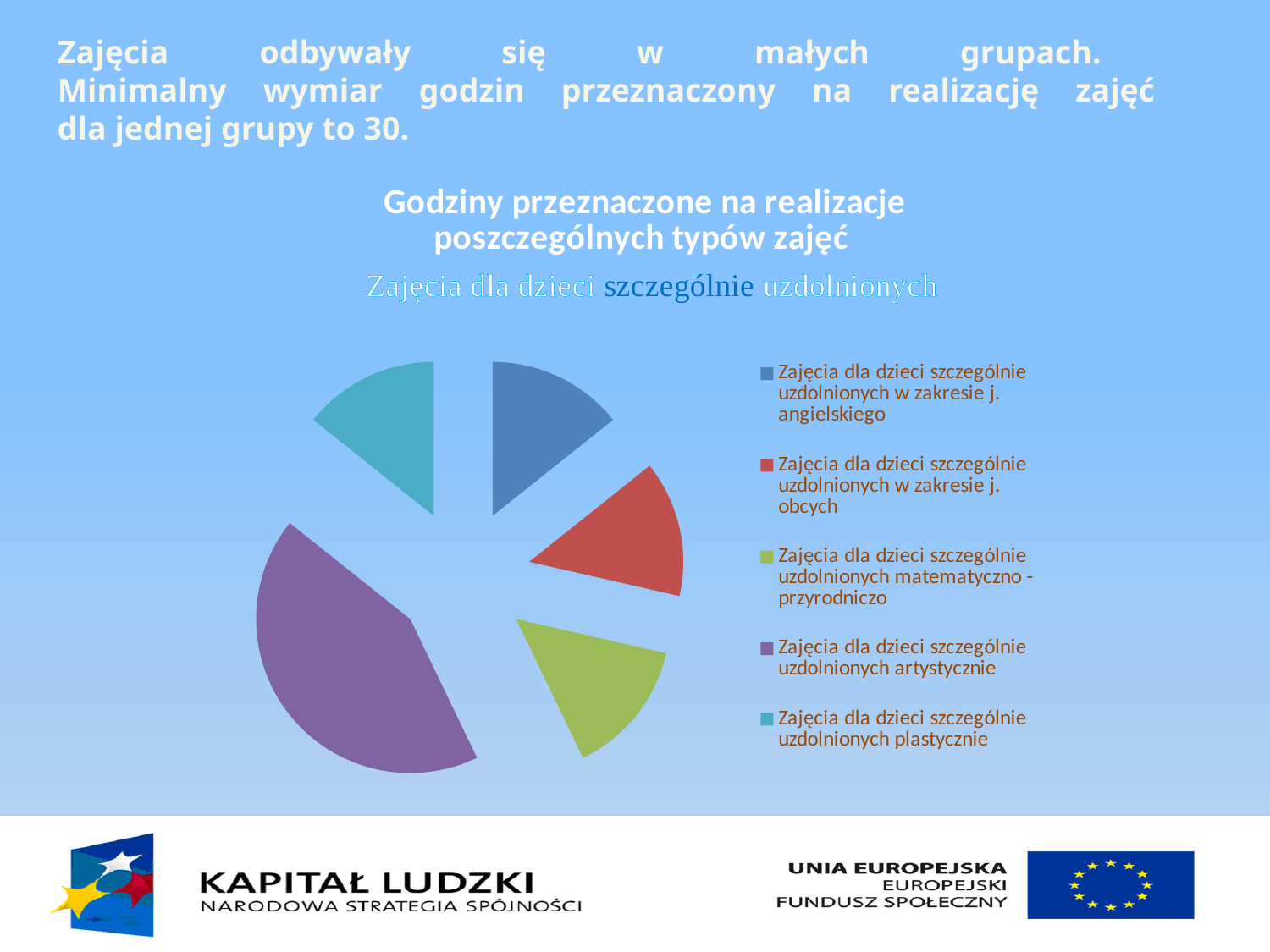
Which category has the largest slice in the pie chart? Zajęcia dla dzieci szczególnie uzdolnionych artystycznie What is the title of the pie chart? Godziny przeznaczone na realizacje poszczególnych typów zajęć What colour is the slice for 'Zajęcia dla dzieci szczególnie uzdolnionych artystycznie'? purple What kind of chart is shown on the slide? pie chart Which slice is larger: 'Zajęcia dla dzieci szczególnie uzdolnionych artystycznie' or 'Zajęcia dla dzieci szczególnie uzdolnionych plastycznie'? Zajęcia dla dzieci szczególnie uzdolnionych artystycznie How many slices does the pie chart have? 5 Which slice is larger: 'Zajęcia dla dzieci szczególnie uzdolnionych artystycznie' or 'Zajęcia dla dzieci szczególnie uzdolnionych w zakresie j. angielskiego'? Zajęcia dla dzieci szczególnie uzdolnionych artystycznie How many entries does the legend of the pie chart list? 5